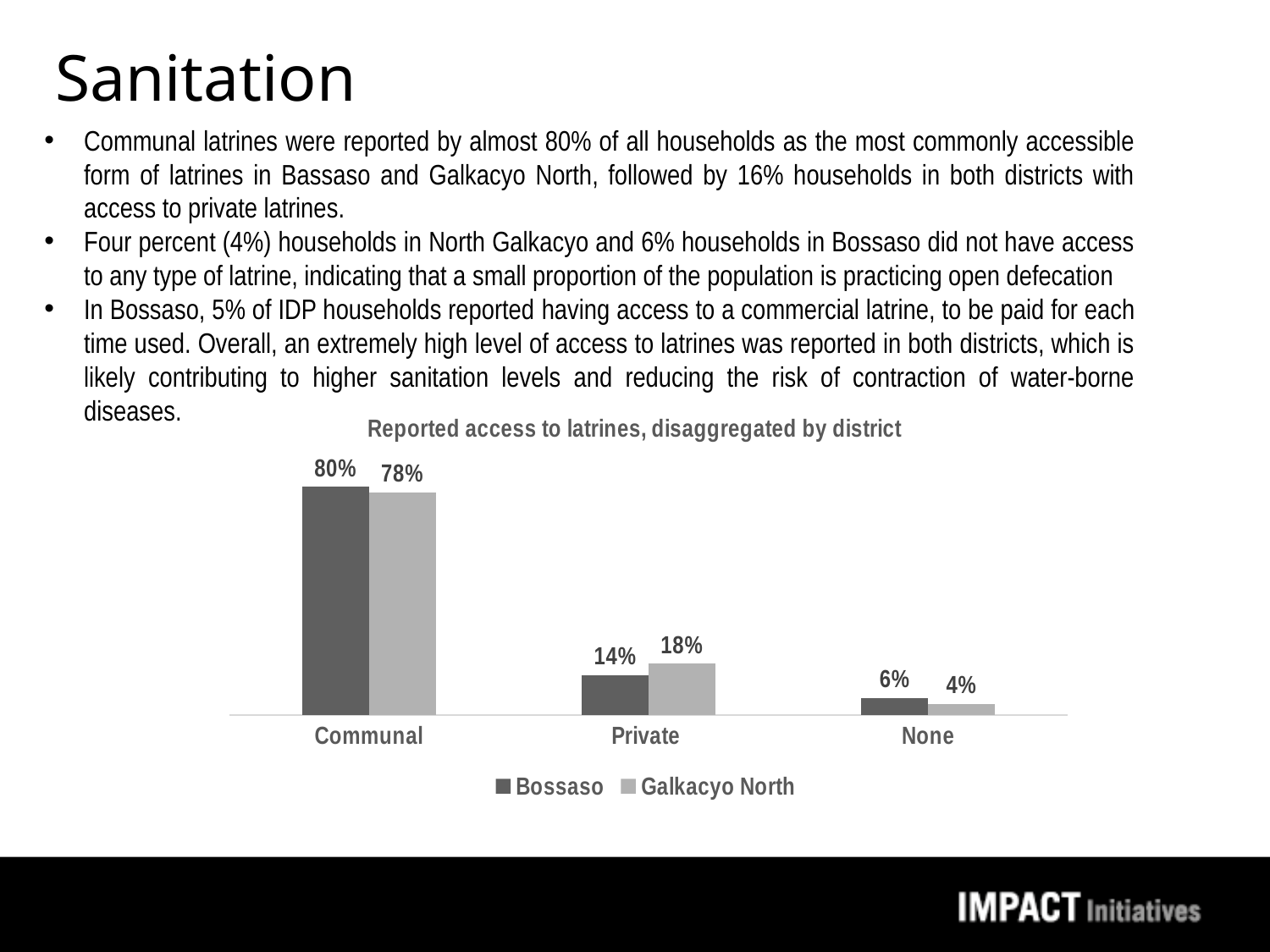
How many series does the legend list? 2 Which category has the highest value for Bossaso? Communal Which category has the lowest value for Galkacyo North? None What is the value for Galkacyo North in the None category? 4% What is the title of the chart? Reported access to latrines, disaggregated by district What kind of chart is shown on the slide? Bar chart What is the value for Galkacyo North in the Private category? 18% What is the difference between the Bossaso and Galkacyo North values in the Communal category? 2% What is the value for Bossaso in the Communal category? 80% In the None category, which series has the larger value, Bossaso or Galkacyo North? Bossaso What is the difference between the Bossaso and Galkacyo North values in the Private category? 4% How many categories are shown on the x axis? 3